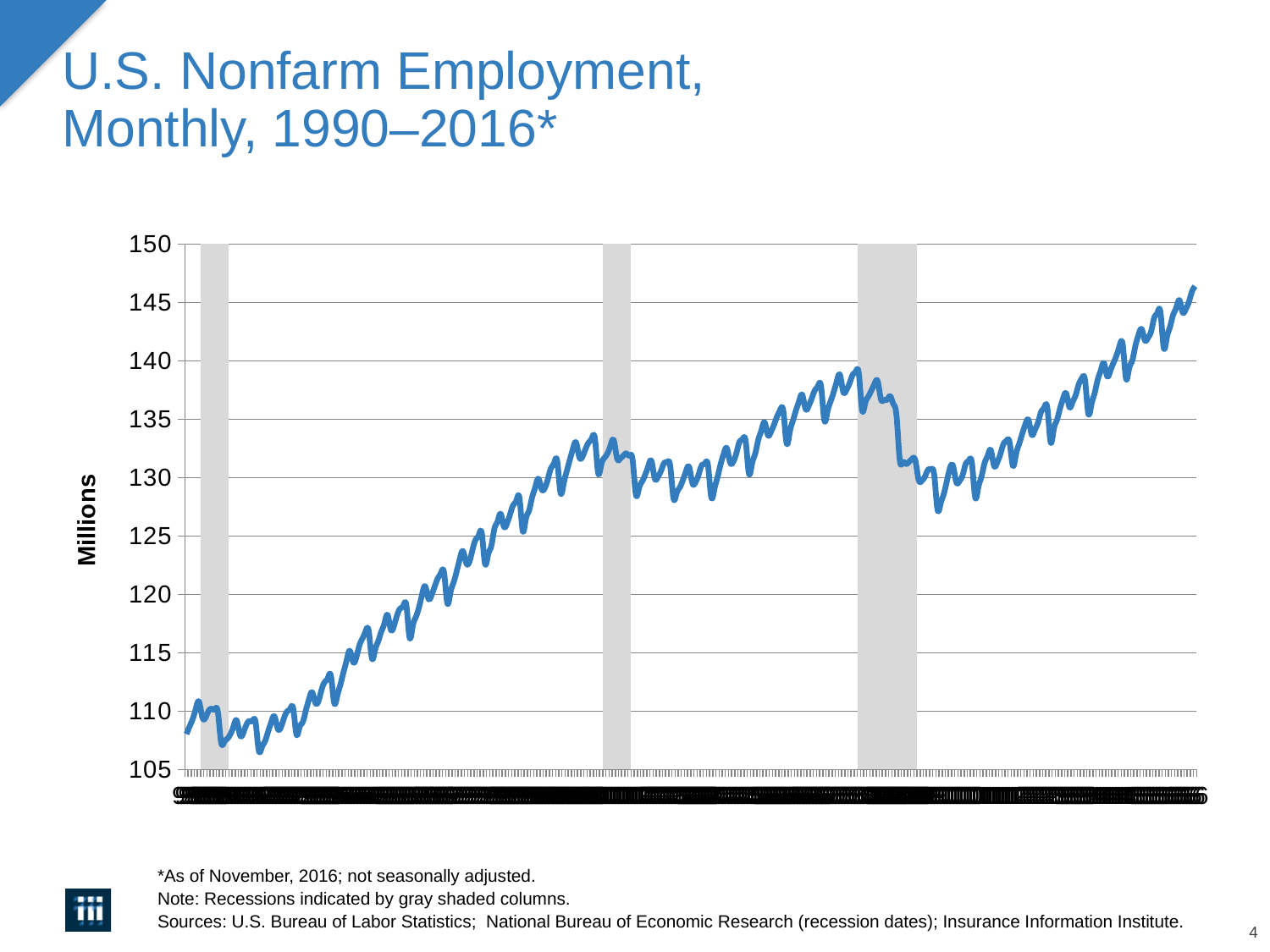
Is the value at the right end of the line higher or lower than the value at the left end of the line? Higher What is the highest value shown on the vertical axis? 150 Is the trough reached just after the third gray shaded recession column greater or less than 130? less What unit is shown on the vertical axis label? Millions What is the title of the chart? U.S. Nonfarm Employment, Monthly, 1990–2016* What kind of chart is shown on the slide? Line chart Is the value at the right end of the line (late 2016) greater or less than 140? greater Is the value at the left end of the line (start of 1990) greater or less than 110? less Overall, does the employment line rise or fall from the left of the chart to the right? Rise How many gray shaded recession columns are shown on the chart? 3